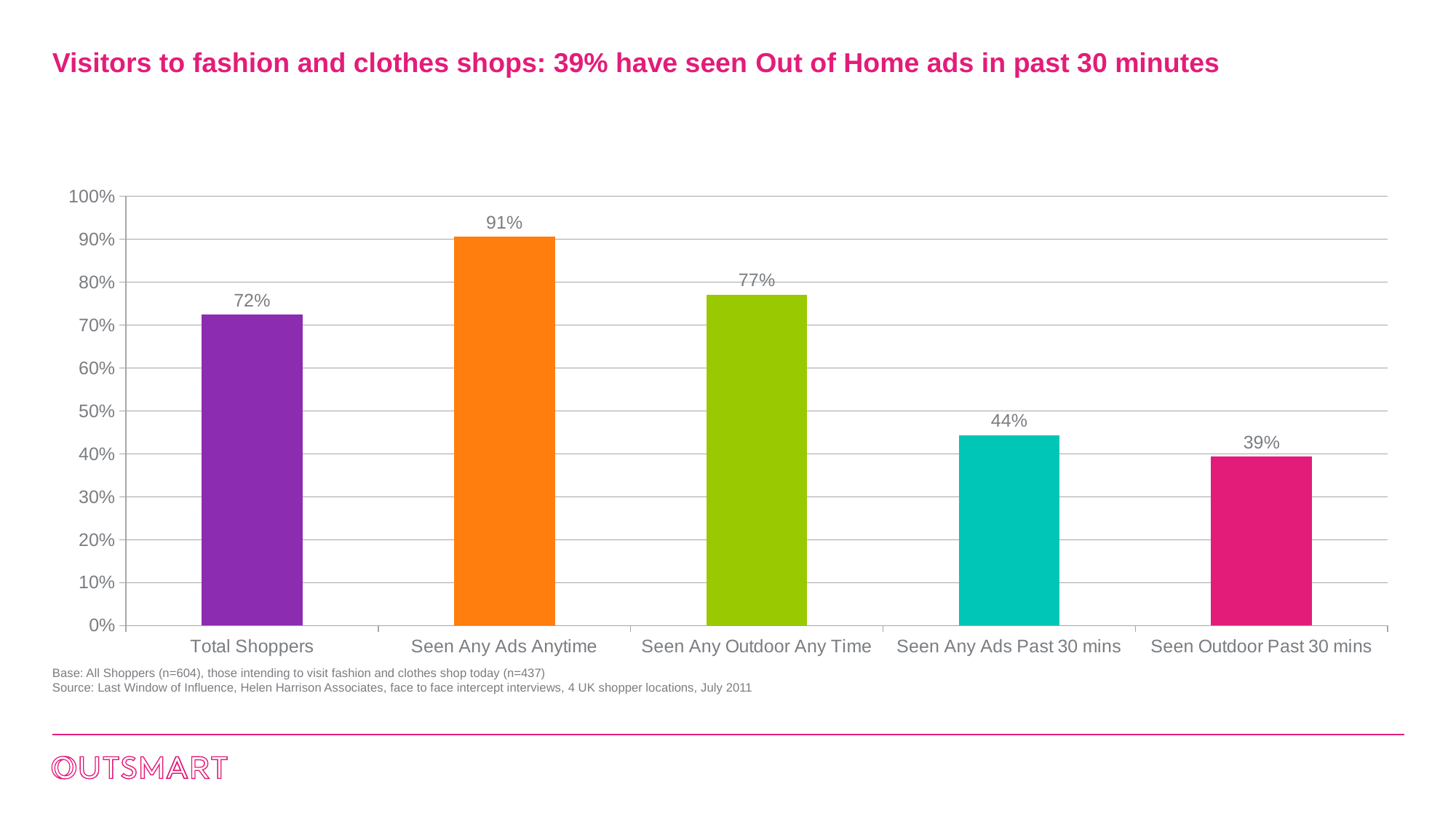
How many categories are shown on the chart? 5 What is the value for Seen Any Ads Past 30 mins? 44% What kind of chart is shown on the slide? Bar chart Is the value for Seen Any Ads Past 30 mins greater or less than 50%? less Which is larger, Total Shoppers or Seen Any Outdoor Any Time? Seen Any Outdoor Any Time Which category has the highest value? Seen Any Ads Anytime What is the difference between Seen Any Ads Past 30 mins and Seen Outdoor Past 30 mins? 5% What is the value for Seen Outdoor Past 30 mins? 39% What is the value for Total Shoppers? 72% What is the difference between Seen Any Ads Anytime and Seen Any Outdoor Any Time? 14% What is the value for Seen Any Ads Anytime? 91% Which category has the lowest value? Seen Outdoor Past 30 mins